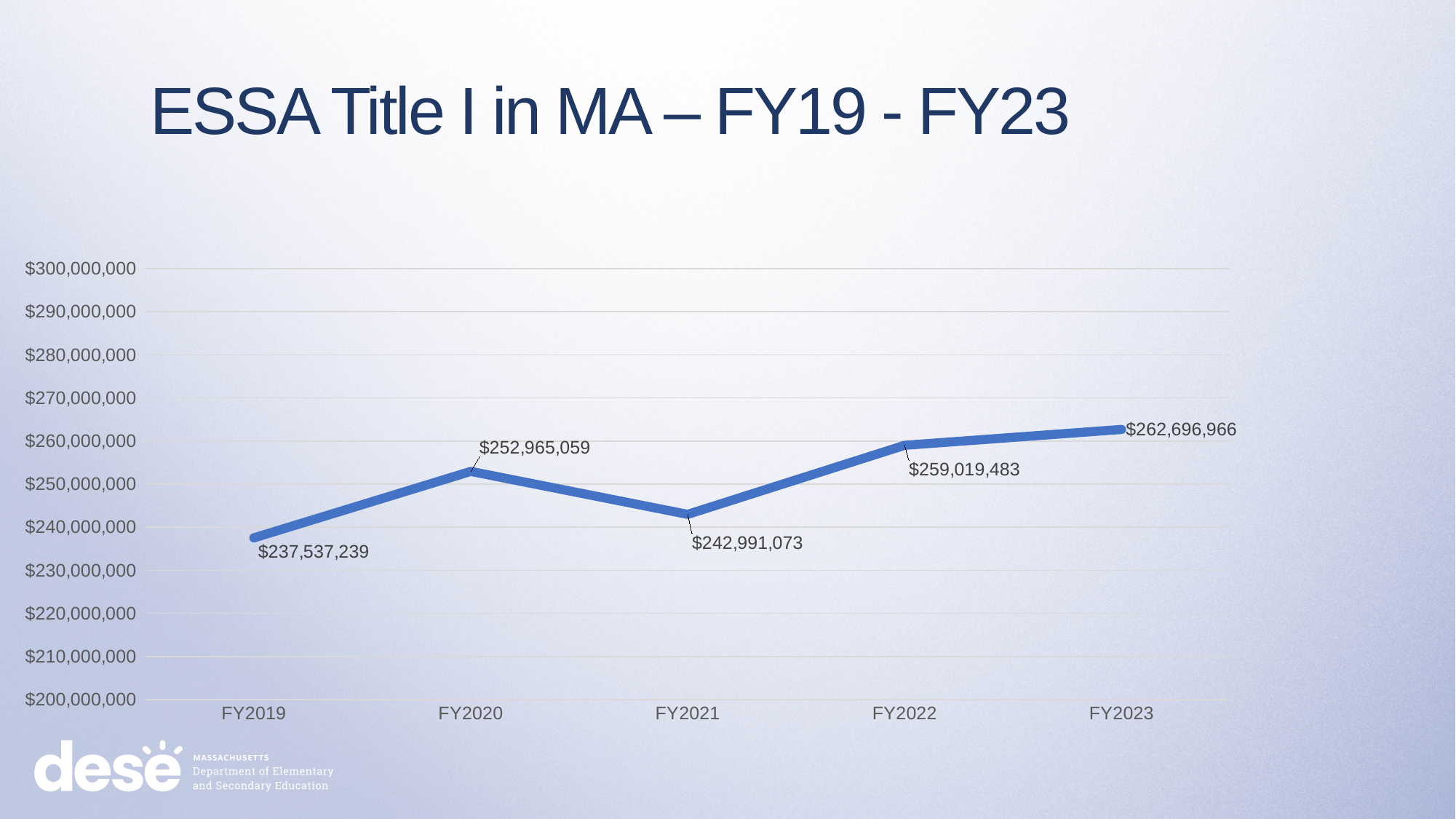
What is the value for FY2021? $242,991,073 What is the difference between the FY2020 value and the FY2021 value? $9,973,986 Does the value rise or fall from FY2020 to FY2021? fall Which is larger, the value for FY2020 or the value for FY2021? FY2020 What is the value for FY2023? $262,696,966 Which fiscal year has the highest value? FY2023 Is the value for FY2022 greater or less than $250,000,000? greater Which fiscal year has the lowest value? FY2019 What is the value for FY2019? $237,537,239 How many fiscal years are plotted on the chart? 5 What kind of chart is shown on the slide? line chart What is the difference between the FY2023 value and the FY2019 value? $25,159,727